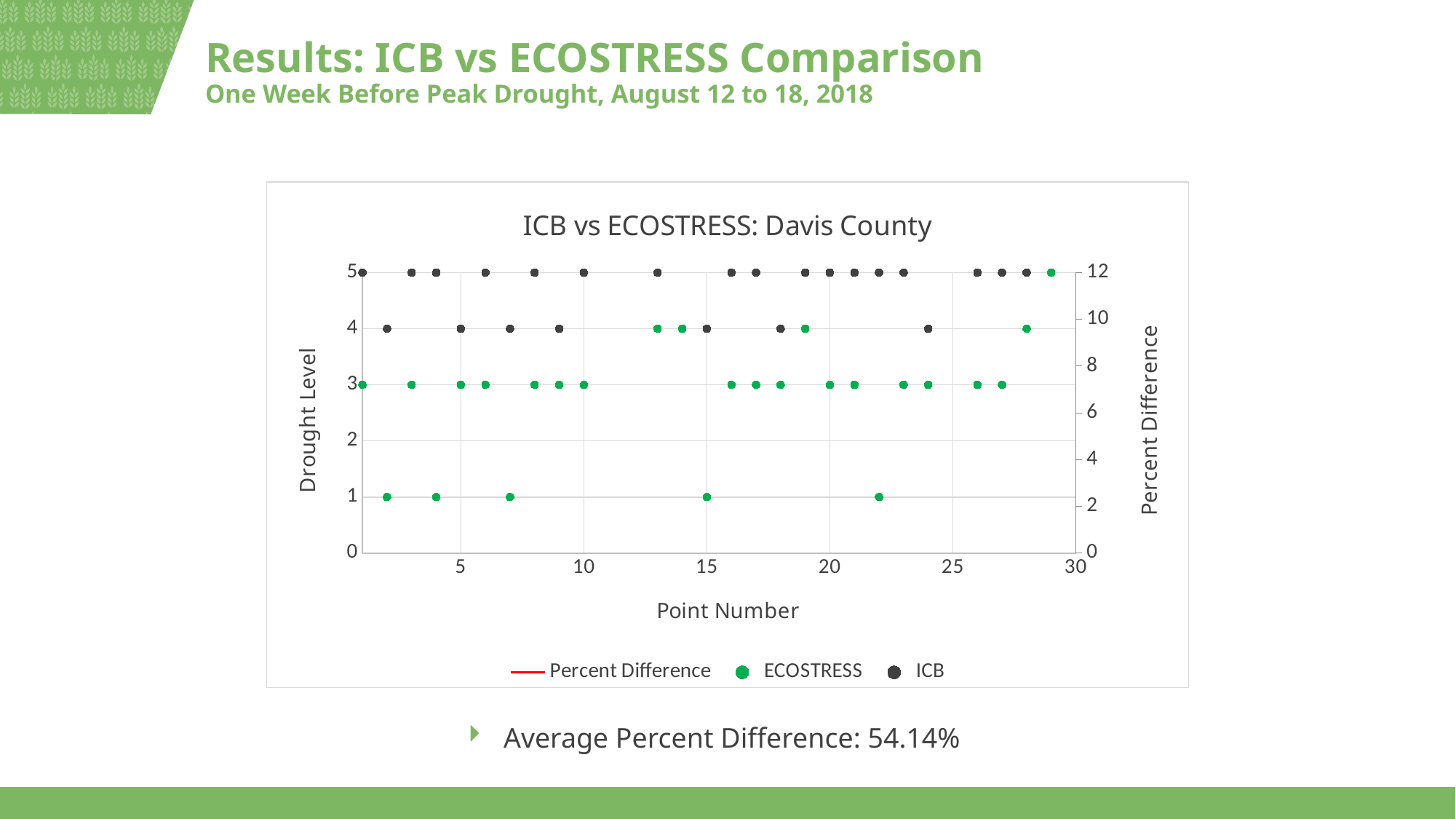
What is the ECOSTRESS drought level at point number 2? 1 How many series does the chart legend list? 3 What is the difference between the ICB and ECOSTRESS drought levels at point number 2? 3 What is the ICB drought level at point number 2? 4 At point number 5, which series has the higher drought level, ICB or ECOSTRESS? ICB What is the ICB drought level at point number 15? 4 What kind of chart is shown on the slide? Scatter chart What is the ECOSTRESS drought level at point number 13? 4 What is the label of the left vertical axis? Drought Level What is the ECOSTRESS drought level at point number 22? 1 What is the highest drought level reached by the ECOSTRESS series? 5 What is the title of the chart? ICB vs ECOSTRESS: Davis County